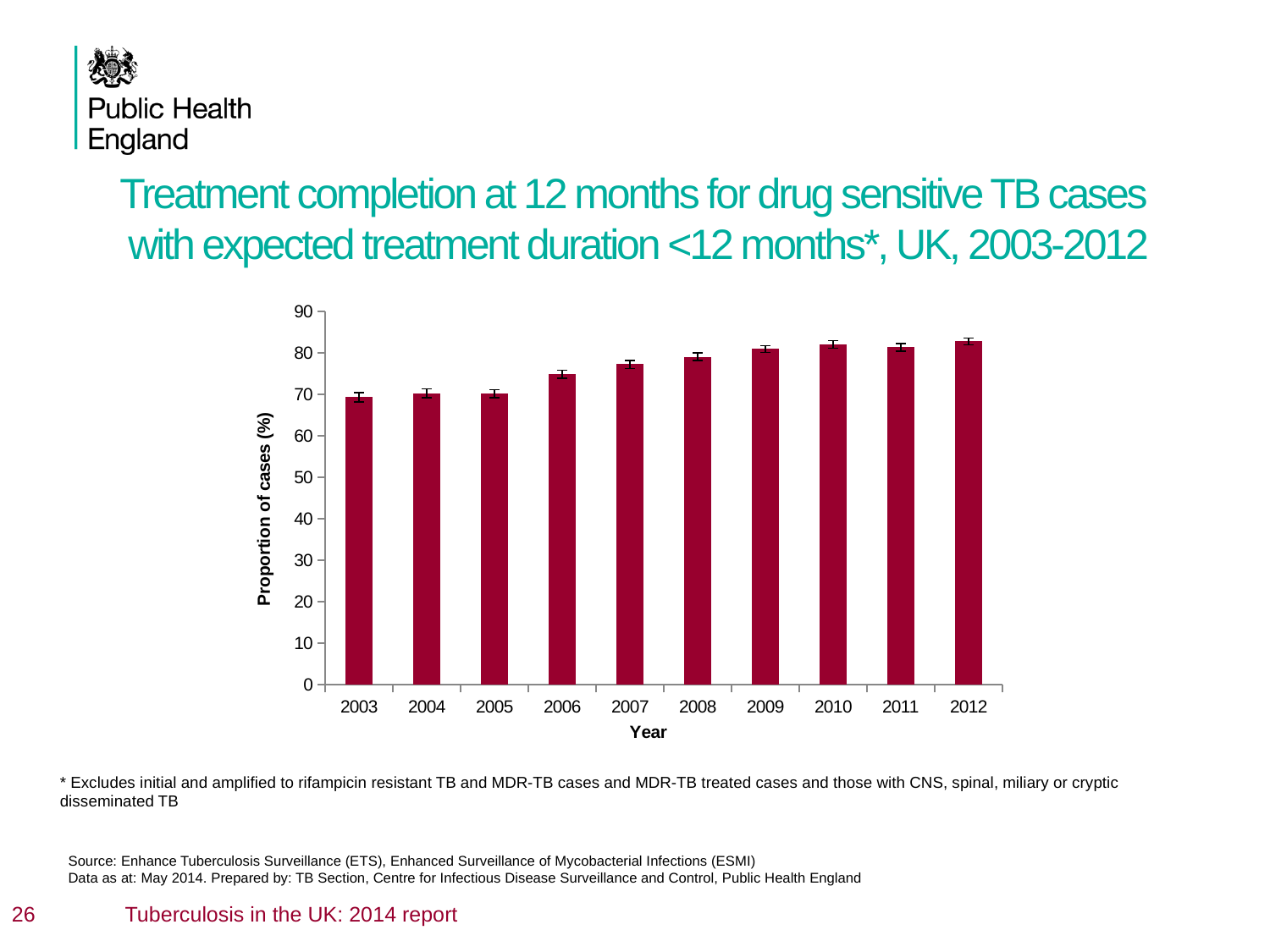
Is the value for 2007 greater or less than 80? less Is the value for 2006 greater or less than 70? greater Which year has the larger value, 2004 or 2006? 2006 What kind of chart is shown on the slide? bar chart How many years are plotted on the x axis of the chart? 10 Is the value for 2010 greater or less than 80? greater Which year has the larger value, 2003 or 2012? 2012 What is the label of the y axis? Proportion of cases (%) Do the values generally rise or fall from 2003 to 2012? rise What is the label of the x axis? Year